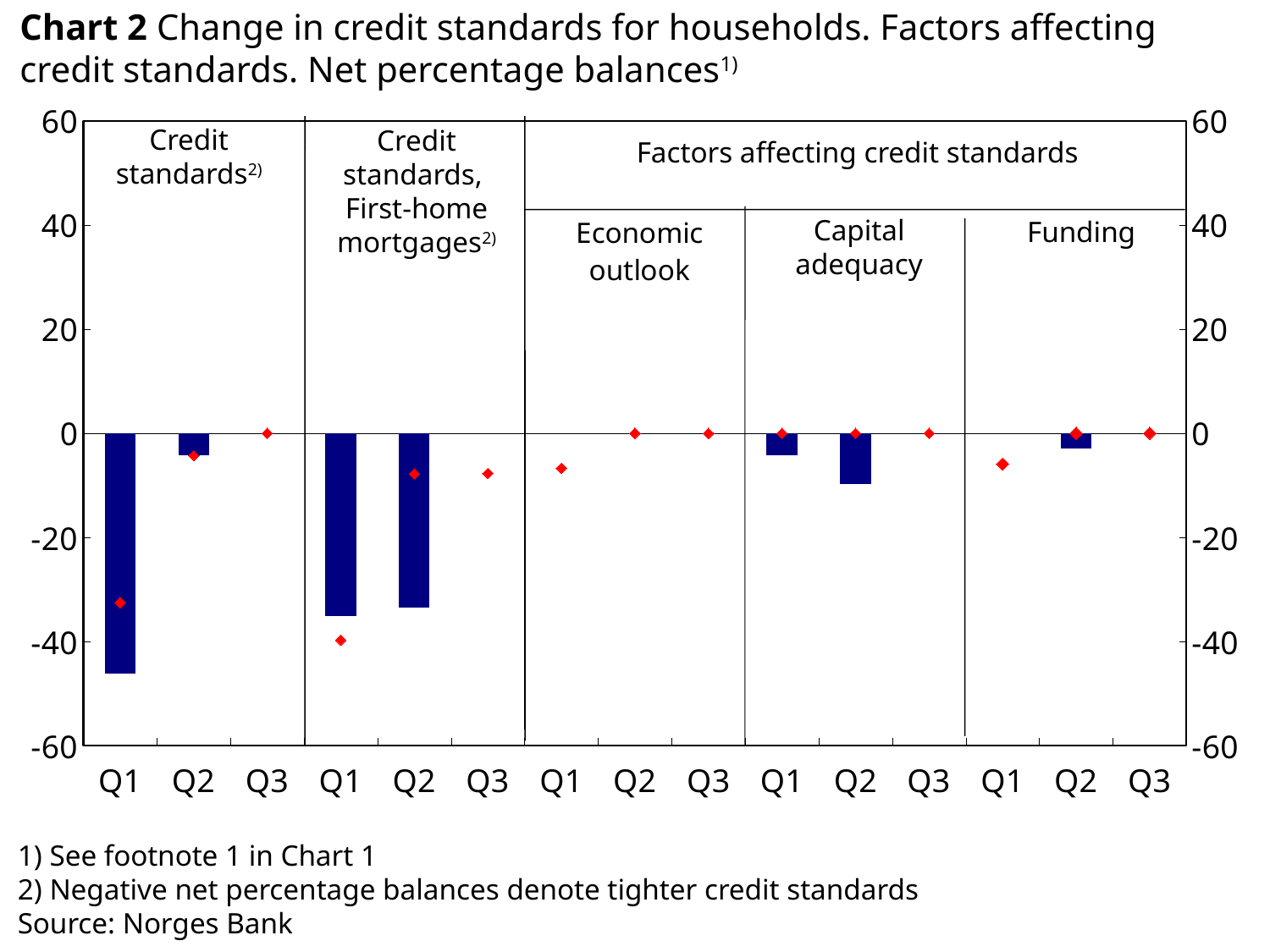
What kind of chart is shown on the slide? Combination bar and line chart (bars with red diamond markers) Across all panels, which bar reaches the lowest (most negative) value? Q1 in the Credit standards panel How many quarters are shown in each panel? 3 In the Credit standards panel, is the red diamond for Q1 greater or less than -20? less In the Credit standards panel, do the bar values rise or fall from Q1 to Q3? rise Among the three Factors affecting credit standards panels, which one contains the most negative bar? Capital adequacy In the Capital adequacy panel, which bar is more negative, Q1 or Q2? Q2 In the Credit standards panel, is the value of the Q1 bar greater or less than -40? less In the Credit standards, First-home mortgages panel, is the value of the Q1 bar greater or less than -40? greater What is the source given for the chart? Norges Bank How many panels (sections) does the chart contain? 5